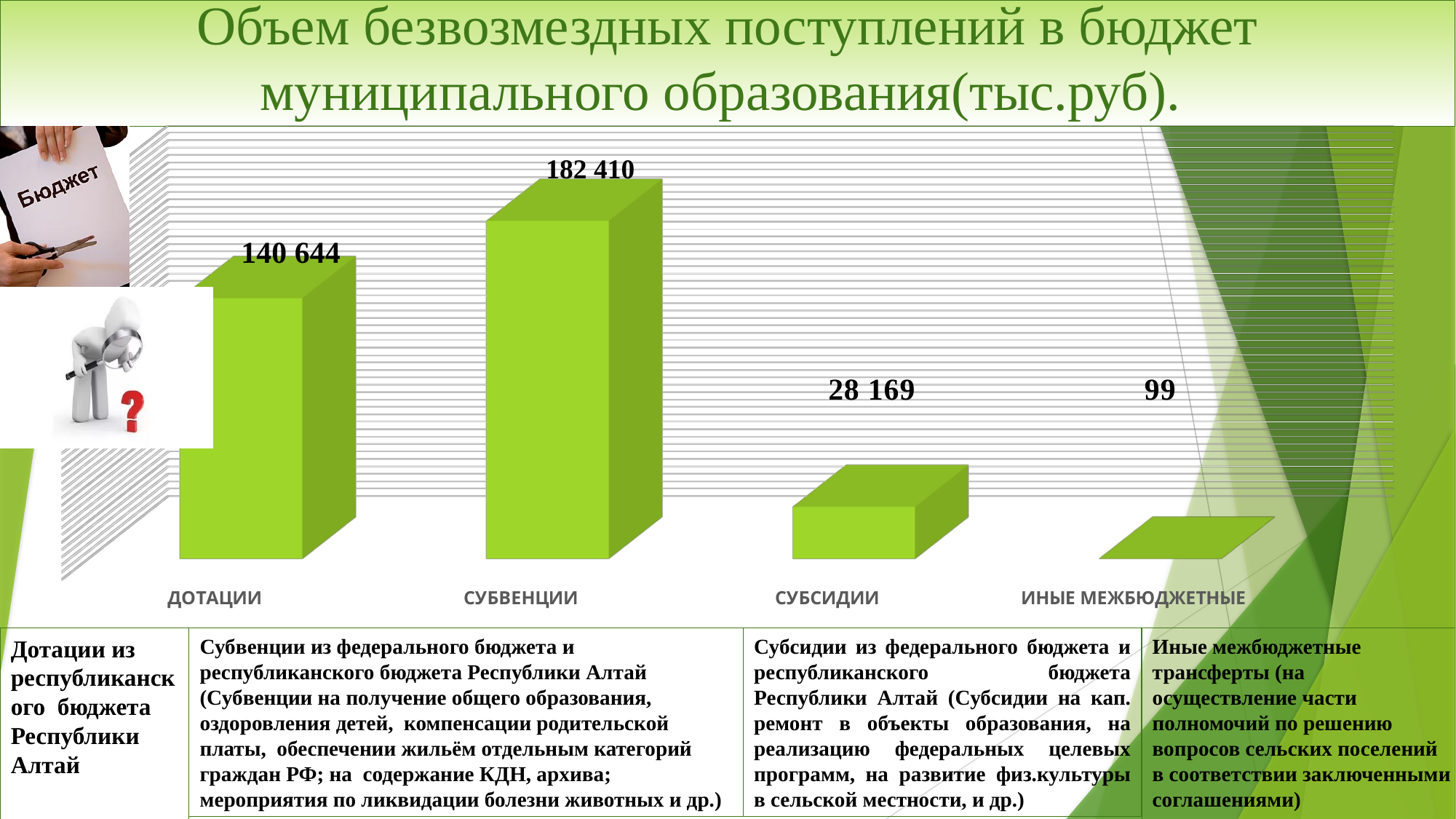
Which category has the highest value? СУБВЕНЦИИ What is the value for ИНЫЕ МЕЖБЮДЖЕТНЫЕ? 99 What unit is given in the chart title for the values? тыс.руб What is the value for ДОТАЦИИ? 140 644 What is the difference between the values for СУБСИДИИ and ИНЫЕ МЕЖБЮДЖЕТНЫЕ? 28 070 Which is larger, the value for ДОТАЦИИ or the value for СУБСИДИИ? ДОТАЦИИ What is the difference between the values for СУБВЕНЦИИ and ДОТАЦИИ? 41 766 What is the value for СУБВЕНЦИИ? 182 410 What kind of chart is shown on the slide? Bar chart How many categories are shown in the chart? 4 What is the value for СУБСИДИИ? 28 169 Which category has the lowest value? ИНЫЕ МЕЖБЮДЖЕТНЫЕ